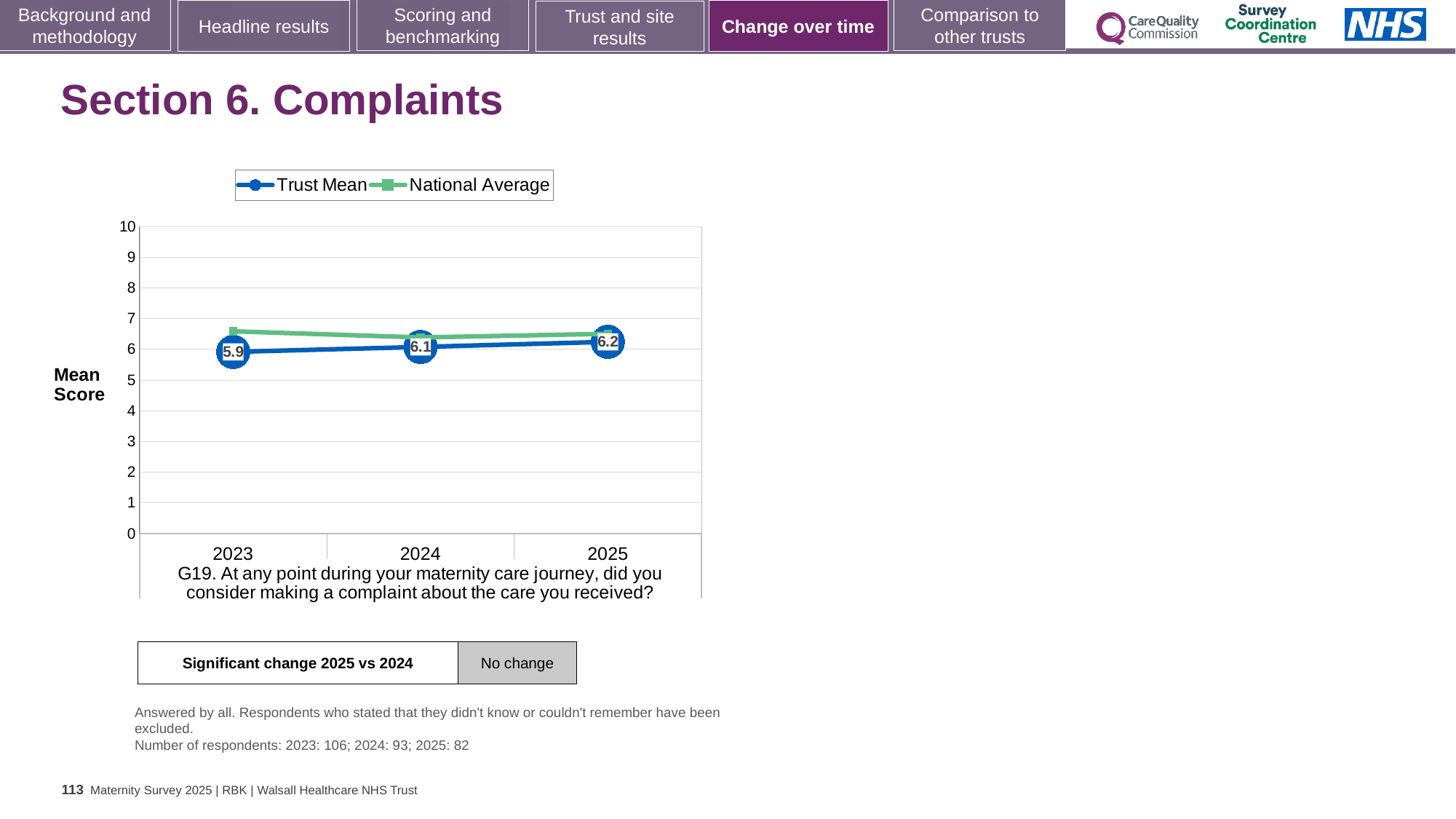
Which is larger, the Trust Mean in 2024 or in 2025? 2025 What is the Trust Mean score for 2024? 6.1 What is the Trust Mean score for 2023? 5.9 Is the National Average value for 2023 greater or less than 6? greater How many series does the legend list? 2 In which year is the Trust Mean highest? 2025 How many years are plotted on the x axis? 3 What kind of chart is shown on the slide? Line chart What is the difference between the Trust Mean in 2025 and in 2023? 0.3 In 2023, which series has the higher value, Trust Mean or National Average? National Average What is the Trust Mean score for 2025? 6.2 In which year is the Trust Mean lowest? 2023